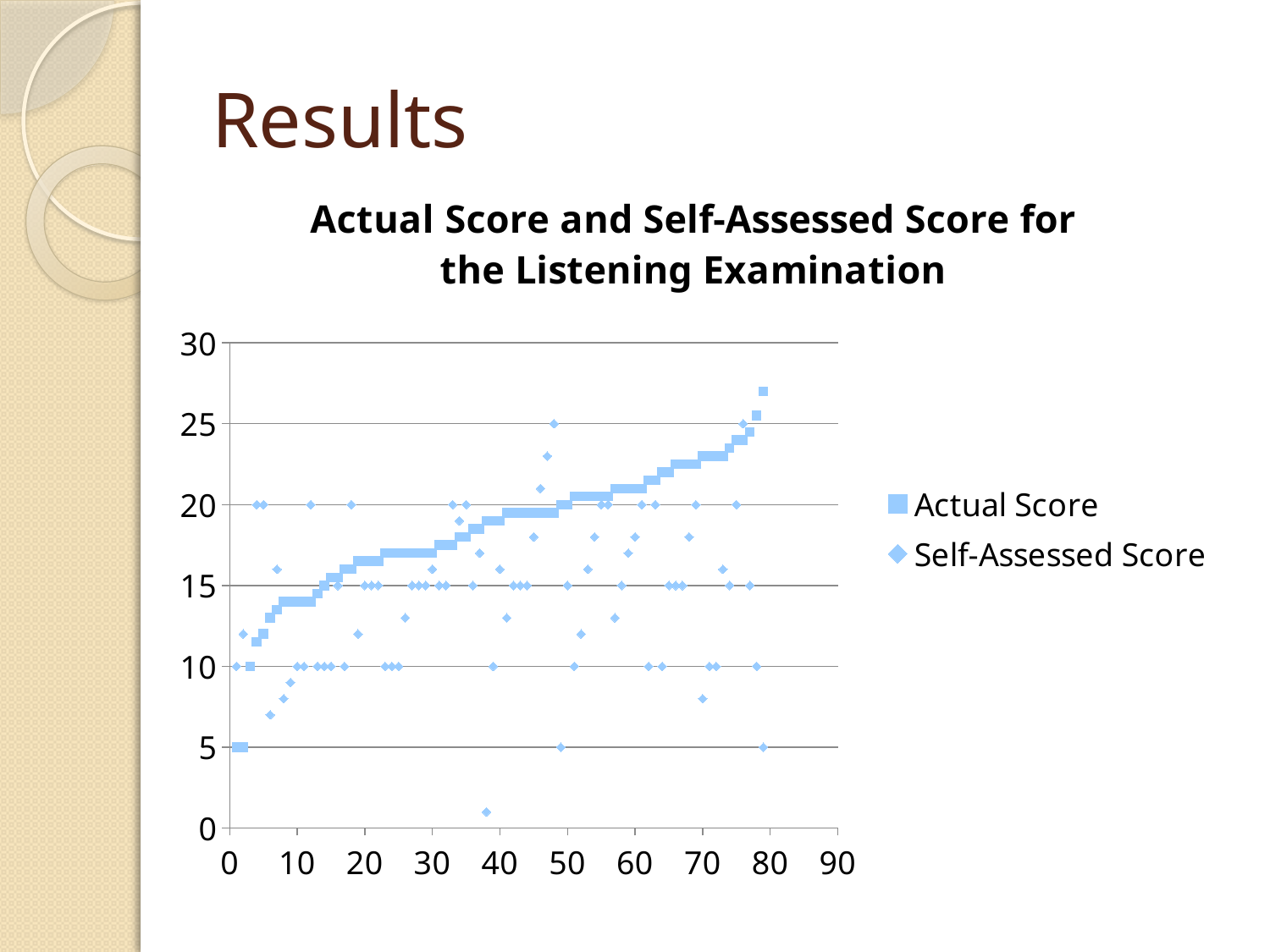
Is the lowest Self-Assessed Score point greater or less than 5? less What is the highest value shown on the y axis? 30 Is the highest Actual Score point greater or less than 25? greater Do the Actual Score values rise or fall as you move along the x axis from left to right? rise Is the Actual Score at x = 50 greater or less than 15? greater What is the title of the chart? Actual Score and Self-Assessed Score for the Listening Examination What kind of chart is shown on the slide? scatter chart What are the two series named in the legend? Actual Score and Self-Assessed Score How many series does the legend list? 2 Which series shows a smooth, steadily increasing pattern: Actual Score or Self-Assessed Score? Actual Score